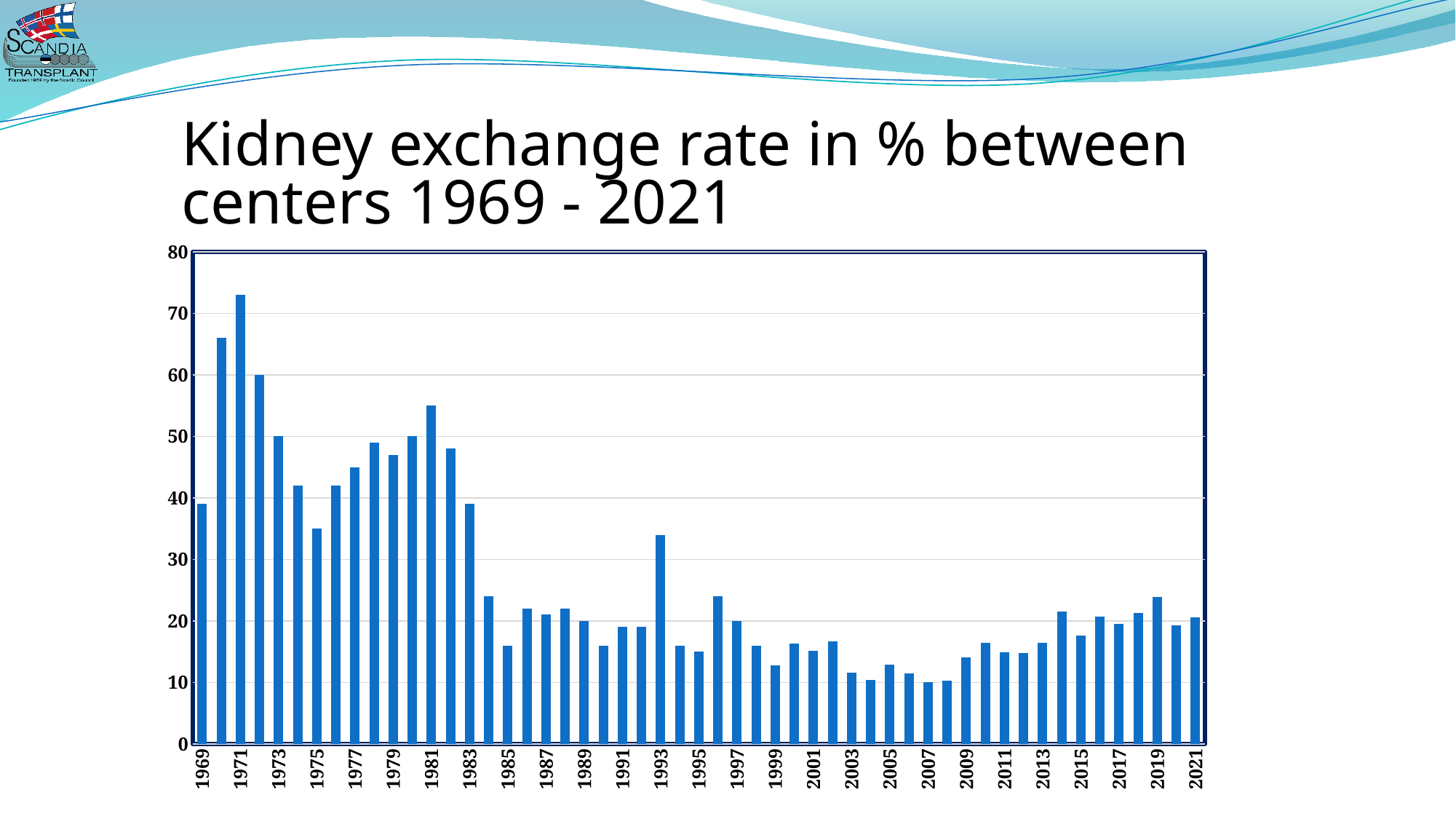
How many years (bars) are plotted on the chart? 53 Which is larger, the value for 1970 or the value for 1972? 1970 Is the value for 1971 greater or less than 70? greater Is the value for 1975 greater or less than 40? less Is the value for 1981 greater or less than 50? greater What kind of chart is shown on the slide? bar chart What is the title of the chart? Kidney exchange rate in % between centers 1969 - 2021 Which is larger, the value for 1993 or the value for 1996? 1993 Which year has the highest kidney exchange rate? 1971 Overall, do the values rise or fall from 1969 to 2021? fall